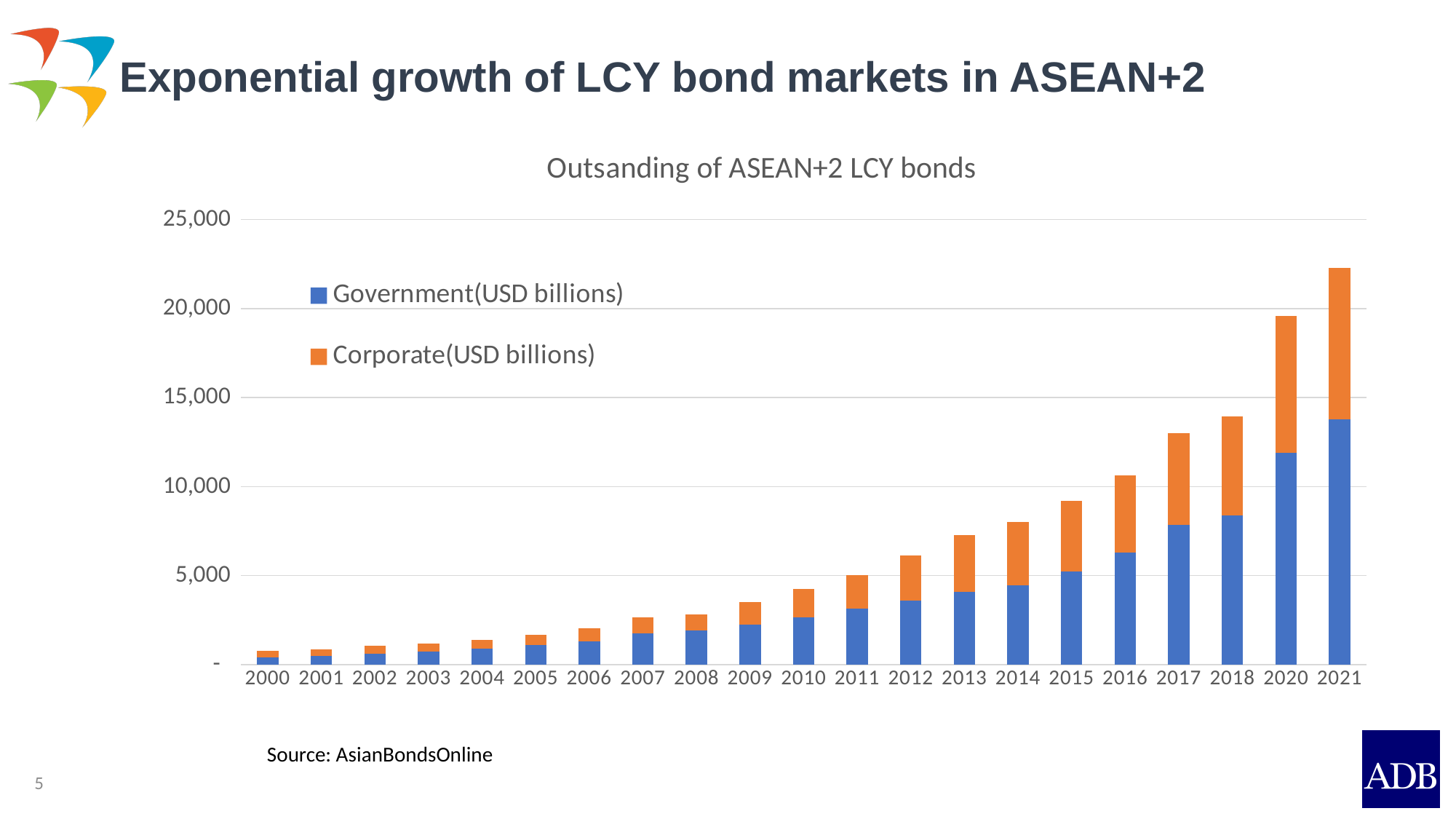
How many years are shown on the x axis? 21 Which year has the highest total outstanding LCY bonds? 2021 What is the title of the chart? Outsanding of ASEAN+2 LCY bonds Is the Government value for 2021 greater or less than 10,000? greater Do the total values generally rise or fall from 2000 to 2021? Rise Is the total value for 2015 greater or less than 10,000? less In 2021, which is larger: the Government segment or the Corporate segment? Government Which year has the lowest total outstanding LCY bonds? 2000 How many series does the legend list? 2 What kind of chart is shown on the slide? Stacked bar chart Is the total value for 2010 greater or less than 5,000? less